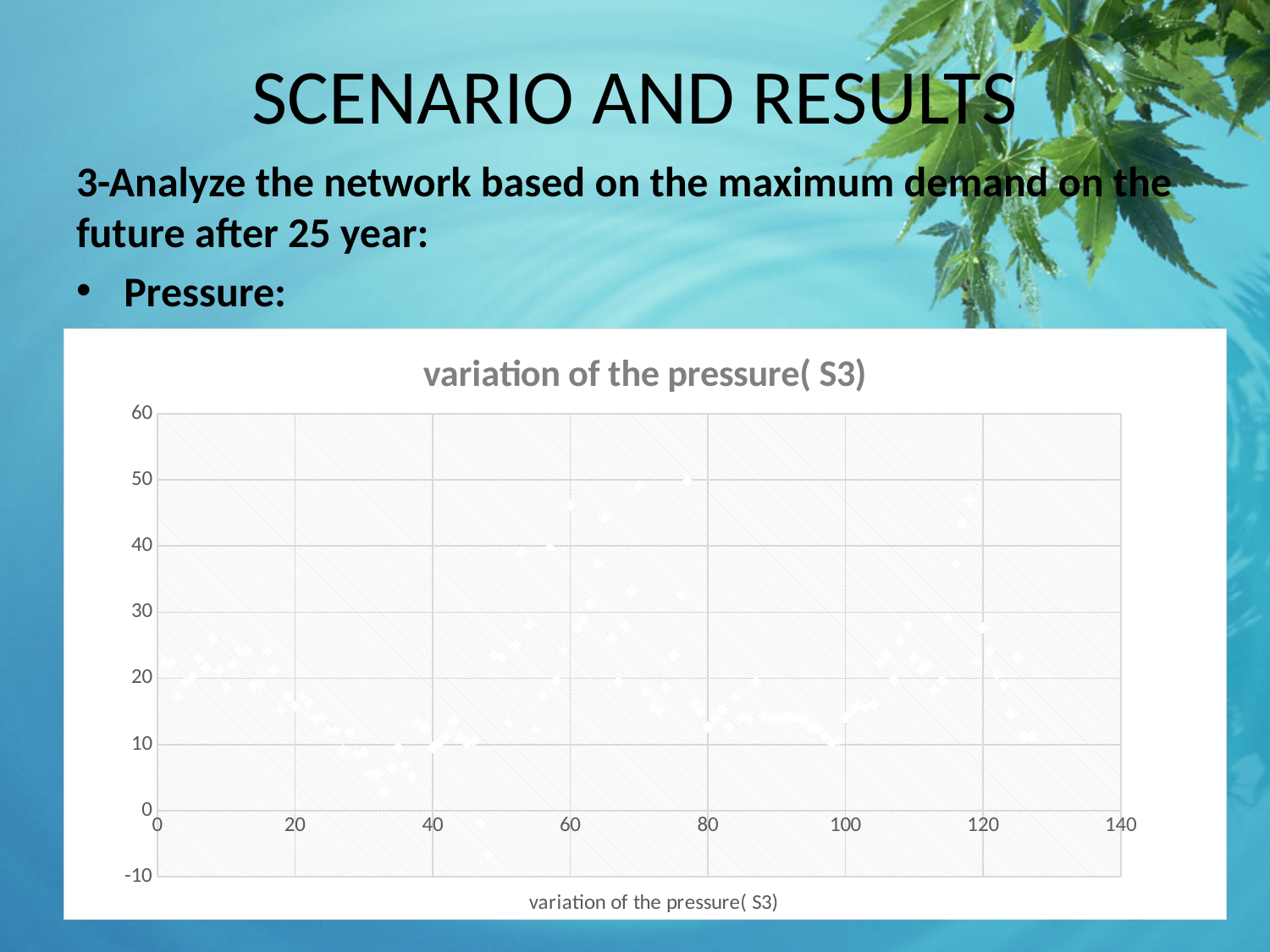
What is the title of the chart? variation of the pressure( S3) What kind of chart is shown on the slide? scatter chart Is the plotted point near x = 60 greater or less than 40? greater What is the highest value shown on the vertical axis of the chart? 60 Is the highest plotted point in the chart greater or less than 60? less How many series does the chart's legend list? 1 Is the plotted point near x = 40 greater or less than 20? less